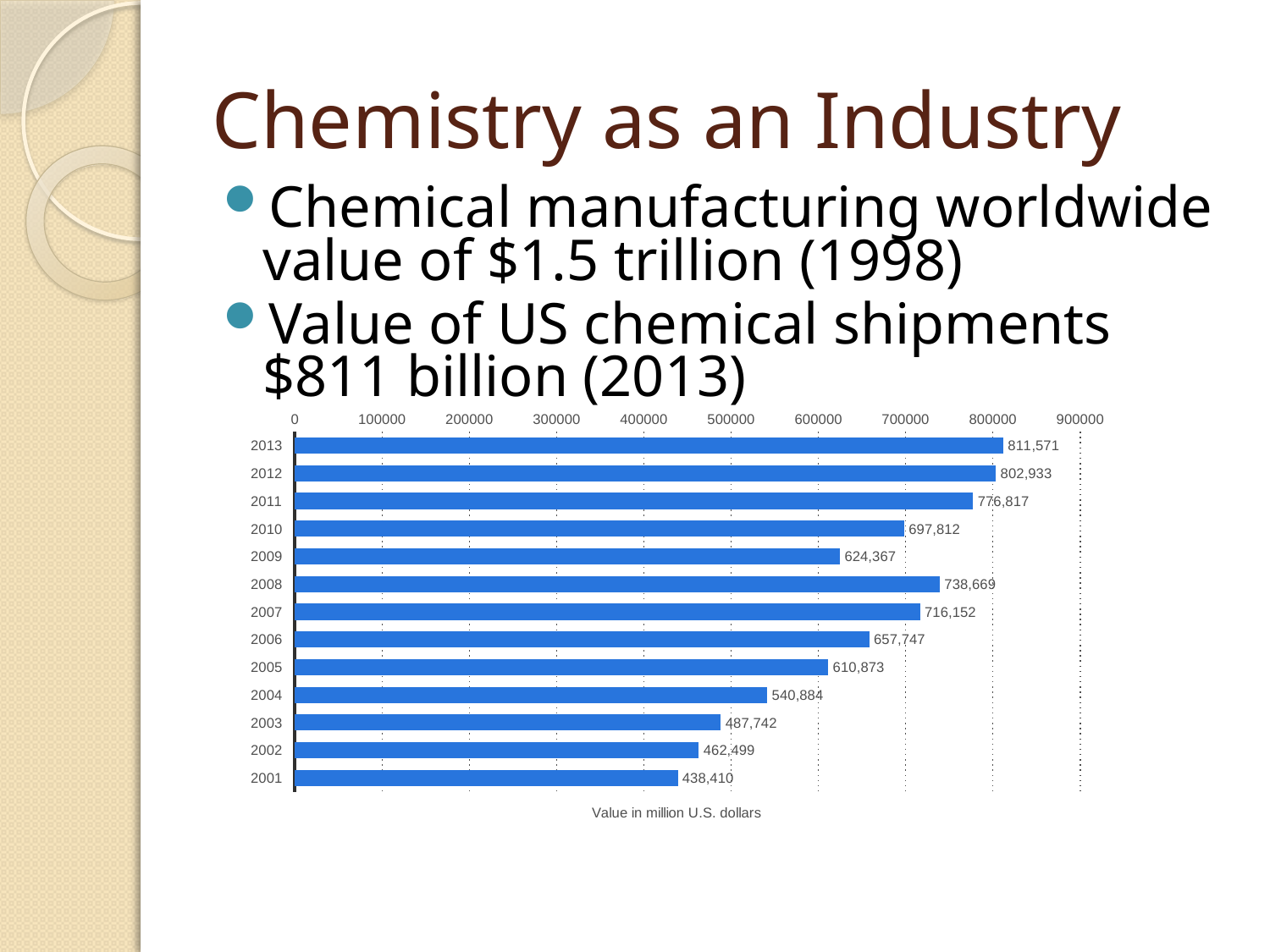
What is the axis label shown below the chart? Value in million U.S. dollars Is the value for 2004 greater or less than 500000? greater Which year has the highest value? 2013 Which is larger, the value for 2008 or the value for 2010? 2008 Which year has the lowest value? 2001 What is the value shown for 2009? 624,367 What kind of chart is shown on the slide? bar chart What is the value shown for 2013? 811,571 What is the difference between the values for 2008 and 2009? 114,302 How many years are shown in the chart? 13 What is the difference between the values for 2013 and 2012? 8,638 What is the value shown for 2001? 438,410